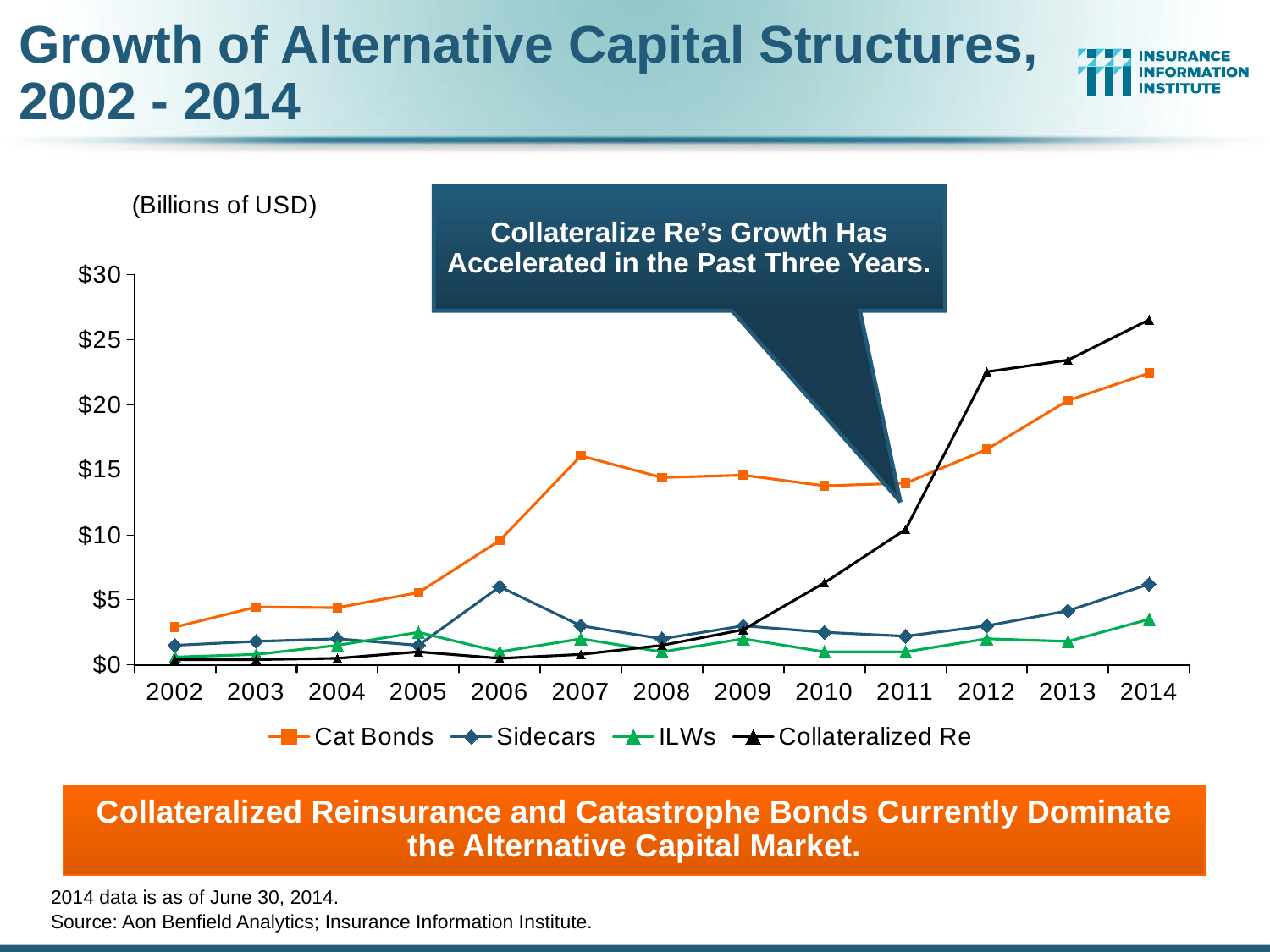
How many series does the legend list? 4 Does the Collateralized Re line rise or fall from 2009 to 2014? Rises What unit is stated for the values on the chart? Billions of USD Is the value for Collateralized Re in 2014 greater or less than $25? greater Which series has the highest value in 2014? Collateralized Re Is the value for Cat Bonds in 2007 greater or less than $10? greater In 2006, which is larger: Sidecars or ILWs? Sidecars How many years are plotted along the x axis? 13 Is the value for Cat Bonds in 2014 greater or less than $20? greater Which series has the highest value in 2007? Cat Bonds What kind of chart is shown on the slide? Line chart